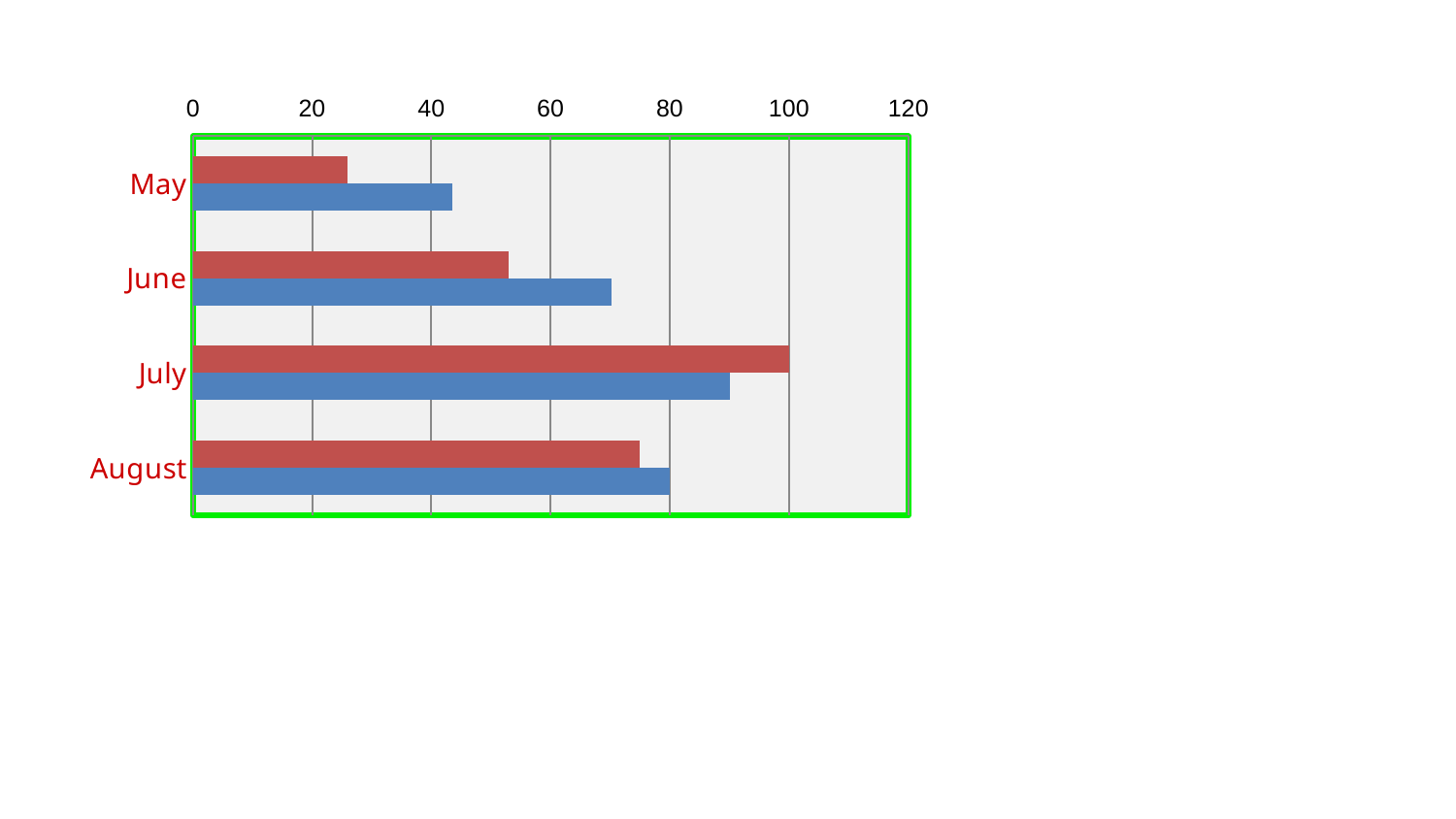
Which month has the longest red bar? July Which month has the shortest red bar? May What is the highest value shown on the horizontal axis? 120 Which month has the longest blue bar? July What kind of chart is shown on the slide? bar chart How many categories (months) are shown on the chart? 4 Is the value of the red bar for May greater or less than 40? less How many bars are plotted for each month? 2 For July, which bar is longer, the red one or the blue one? red What is the value of the red bar for July? 100 Is the value of the blue bar for June greater or less than 60? greater